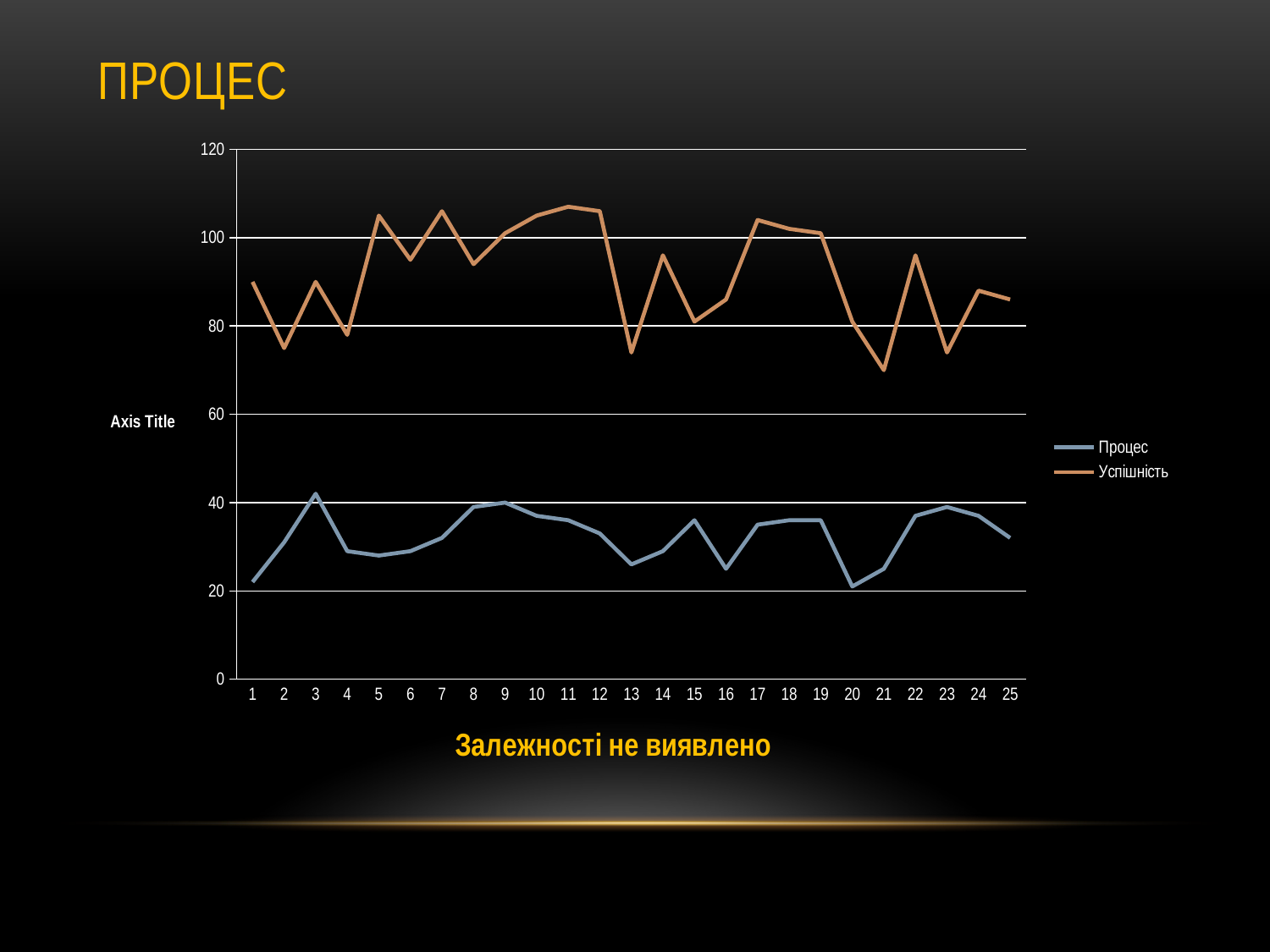
Is the value of Успішність at point 5 greater or less than 100? greater Is the value of Процес at point 20 greater or less than 40? less Is the value of Успішність at point 21 greater or less than 80? less What kind of chart is shown on the slide? line chart What caption is written below the chart? Залежності не виявлено At which point does the Успішність series reach its lowest value? 21 Which is larger, the value of Успішність at point 5 or at point 4? point 5 Which series has the lower values throughout the chart, Процес or Успішність? Процес What are the two entries in the chart legend? Процес and Успішність How many series does the legend list? 2 How many points are plotted along the x axis for each series? 25